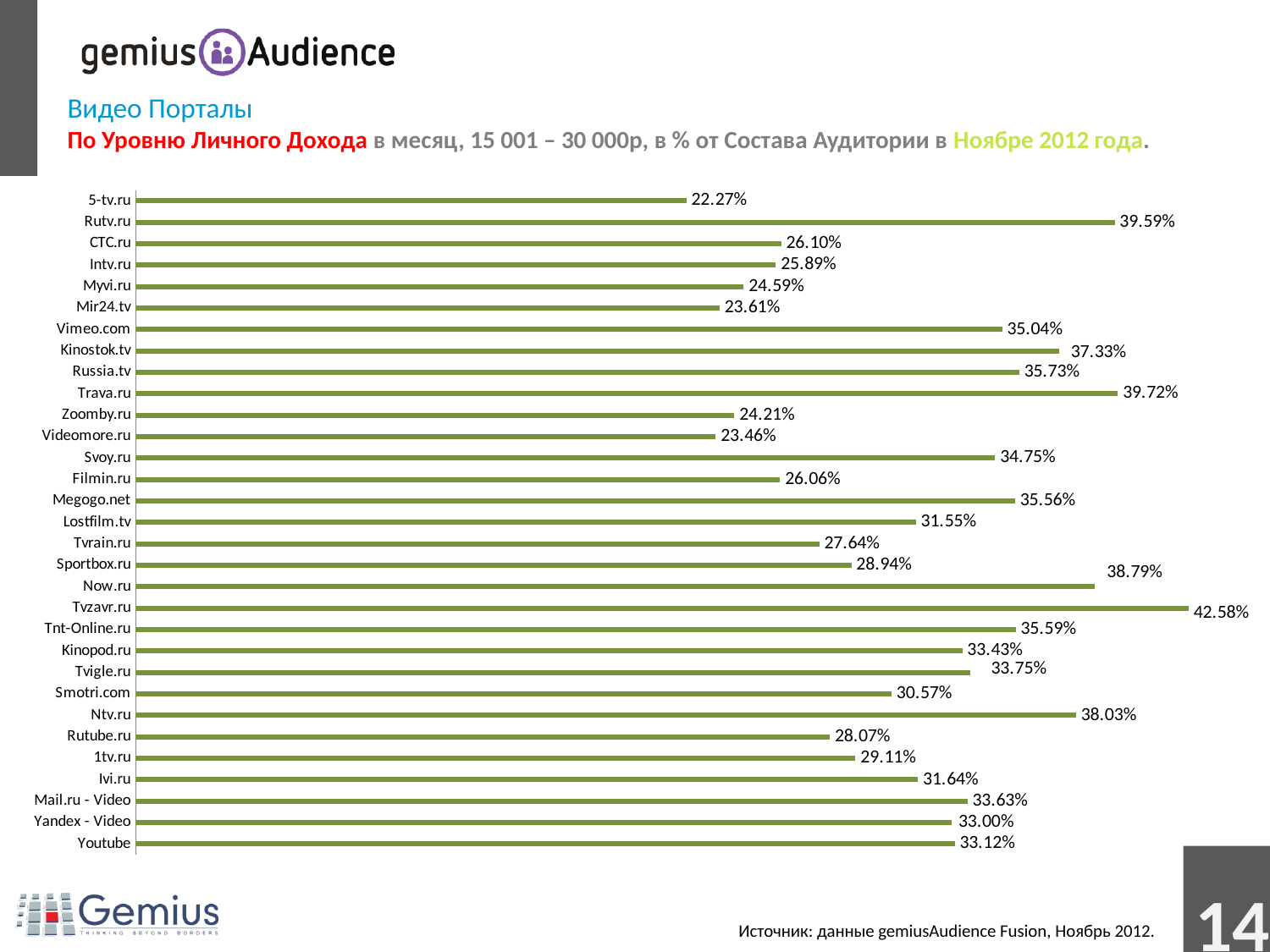
What is the difference between the values for Tvzavr.ru and 5-tv.ru? 20.31% What is the value for Youtube? 33.12% What is the value for Ivi.ru? 31.64% What kind of chart is shown on the slide? Bar chart Which month and year does the chart's data refer to, according to the title? November 2012 (Ноябрь 2012 года) What is the value for Rutv.ru? 39.59% Which has a larger value, Kinostok.tv or Vimeo.com? Kinostok.tv What is the difference between the values for Trava.ru and Rutv.ru? 0.13% What is the value for Mir24.tv? 23.61% Which portal has the highest value? Tvzavr.ru How many portals are shown in the chart? 31 Which portal has the lowest value? 5-tv.ru